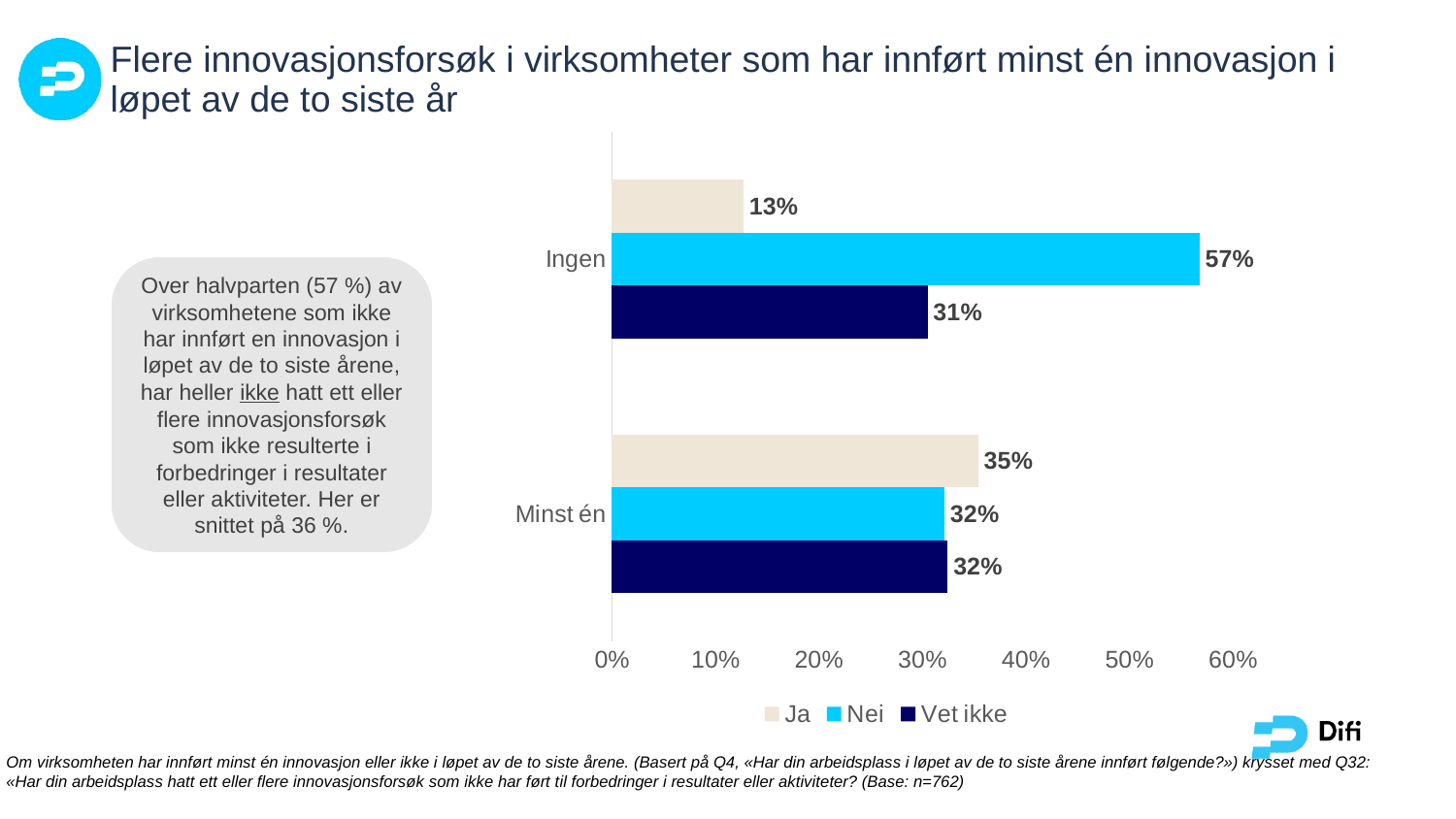
What is the value for "Nei" in the "Ingen" category? 57% Which is larger: the "Ja" value for "Ingen" or the "Ja" value for "Minst én"? Minst én What is the value for "Vet ikke" in the "Ingen" category? 31% How many categories are shown on the chart? 2 Which series has the lowest value in the "Ingen" category? Ja What is the value for "Ja" in the "Minst én" category? 35% What is the difference between the "Nei" values for "Ingen" and "Minst én"? 25 percentage points What kind of chart is shown on the slide? Bar chart Which series has the highest value in the "Ingen" category? Nei How many series does the legend list? 3 What is the value for "Ja" in the "Ingen" category? 13% Is the value for "Nei" in the "Ingen" category greater or less than 50%? greater